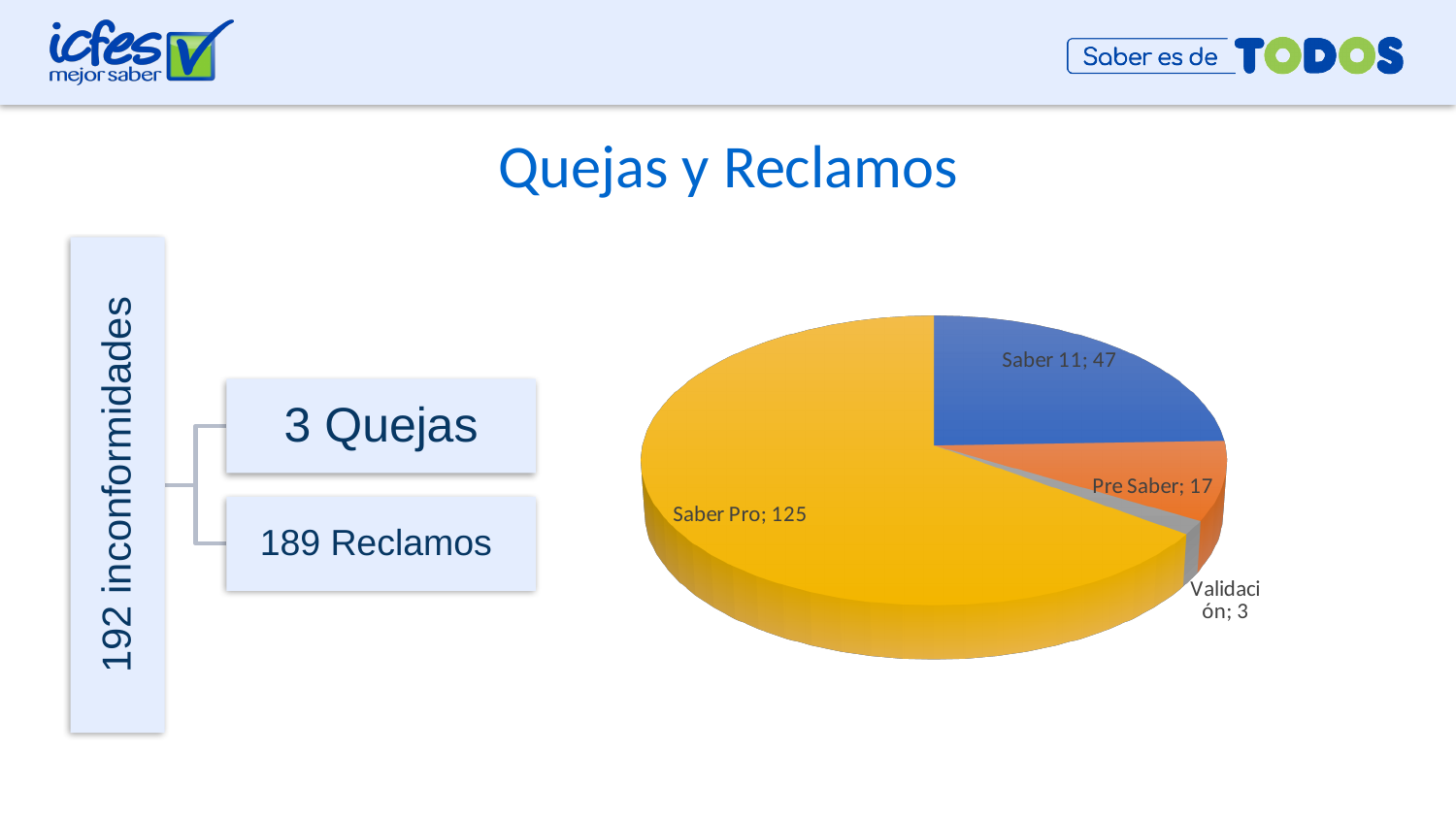
How many categories are shown in the pie chart? 4 What is the value for Validación in the pie chart? 3 What is the value for Saber Pro in the pie chart? 125 What is the difference between the values for Saber Pro and Saber 11? 78 Which is larger, the value for Saber 11 or the value for Pre Saber? Saber 11 What is the value for Saber 11 in the pie chart? 47 What is the total of all the slices in the pie chart? 192 What is the title of the slide containing the pie chart? Quejas y Reclamos What type of chart is shown on the slide? pie chart Which category has the smallest slice in the pie chart? Validación Which category has the largest slice in the pie chart? Saber Pro What is the value for Pre Saber in the pie chart? 17